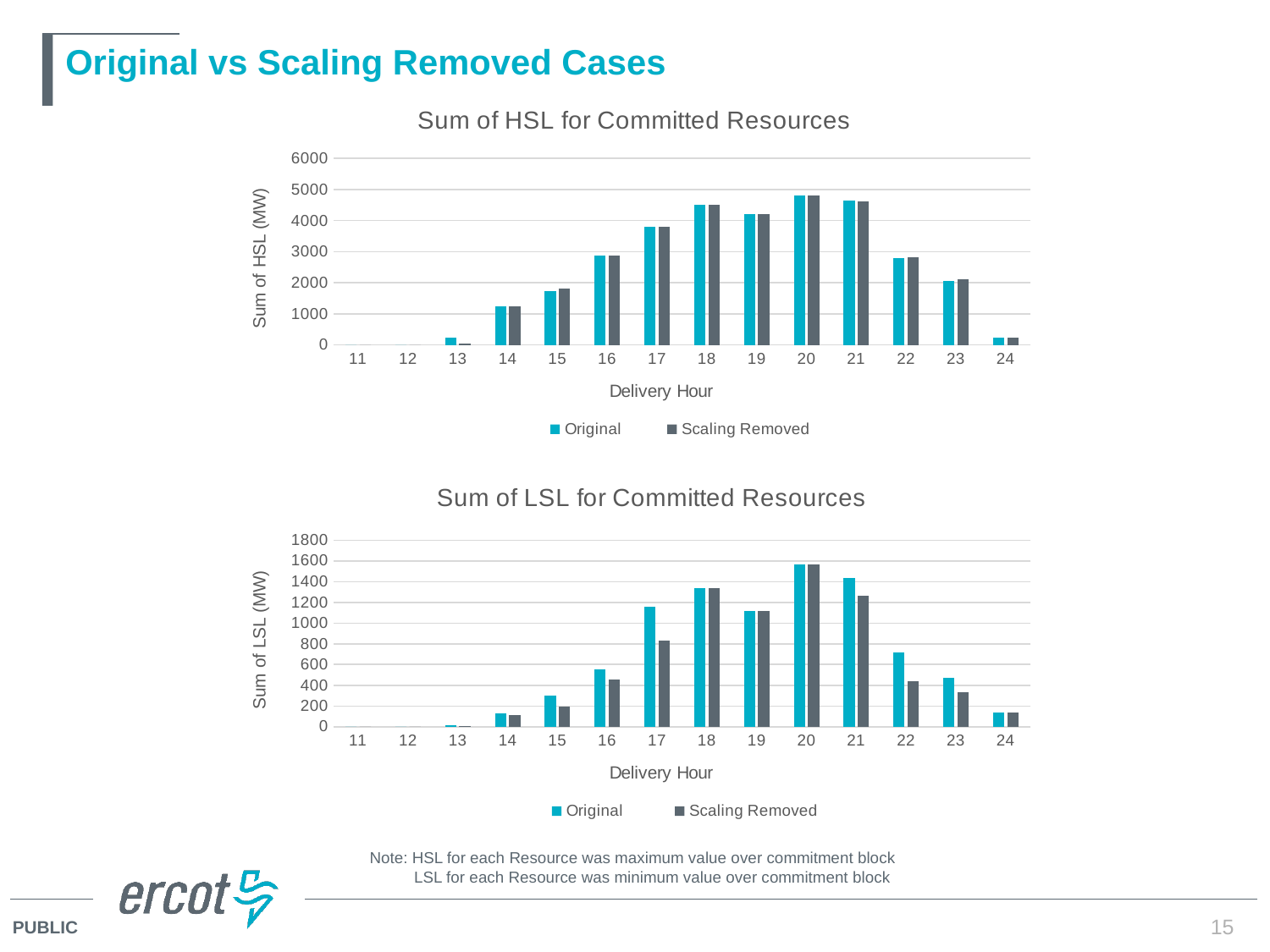
In the 'Sum of HSL for Committed Resources' chart, is the Original value for delivery hour 24 greater or less than 1000? less In the 'Sum of HSL for Committed Resources' chart, do the Original values rise or fall from delivery hour 14 to delivery hour 20? rise In the 'Sum of LSL for Committed Resources' chart, is the Original value for delivery hour 20 greater or less than 1400? greater How many delivery hours are shown on the x axis of the 'Sum of HSL for Committed Resources' chart? 14 In the 'Sum of LSL for Committed Resources' chart, is the Scaling Removed value for delivery hour 17 greater or less than 1000? less In the 'Sum of HSL for Committed Resources' chart, which delivery hour has the highest Original value? 20 How many series does the legend of the 'Sum of LSL for Committed Resources' chart list? 2 In the 'Sum of LSL for Committed Resources' chart, which is larger at delivery hour 22: the Original value or the Scaling Removed value? Original What type of chart is the 'Sum of HSL for Committed Resources' chart? Bar chart In the 'Sum of LSL for Committed Resources' chart, which delivery hour has the highest Scaling Removed value? 20 What is the y-axis title of the 'Sum of LSL for Committed Resources' chart? Sum of LSL (MW)